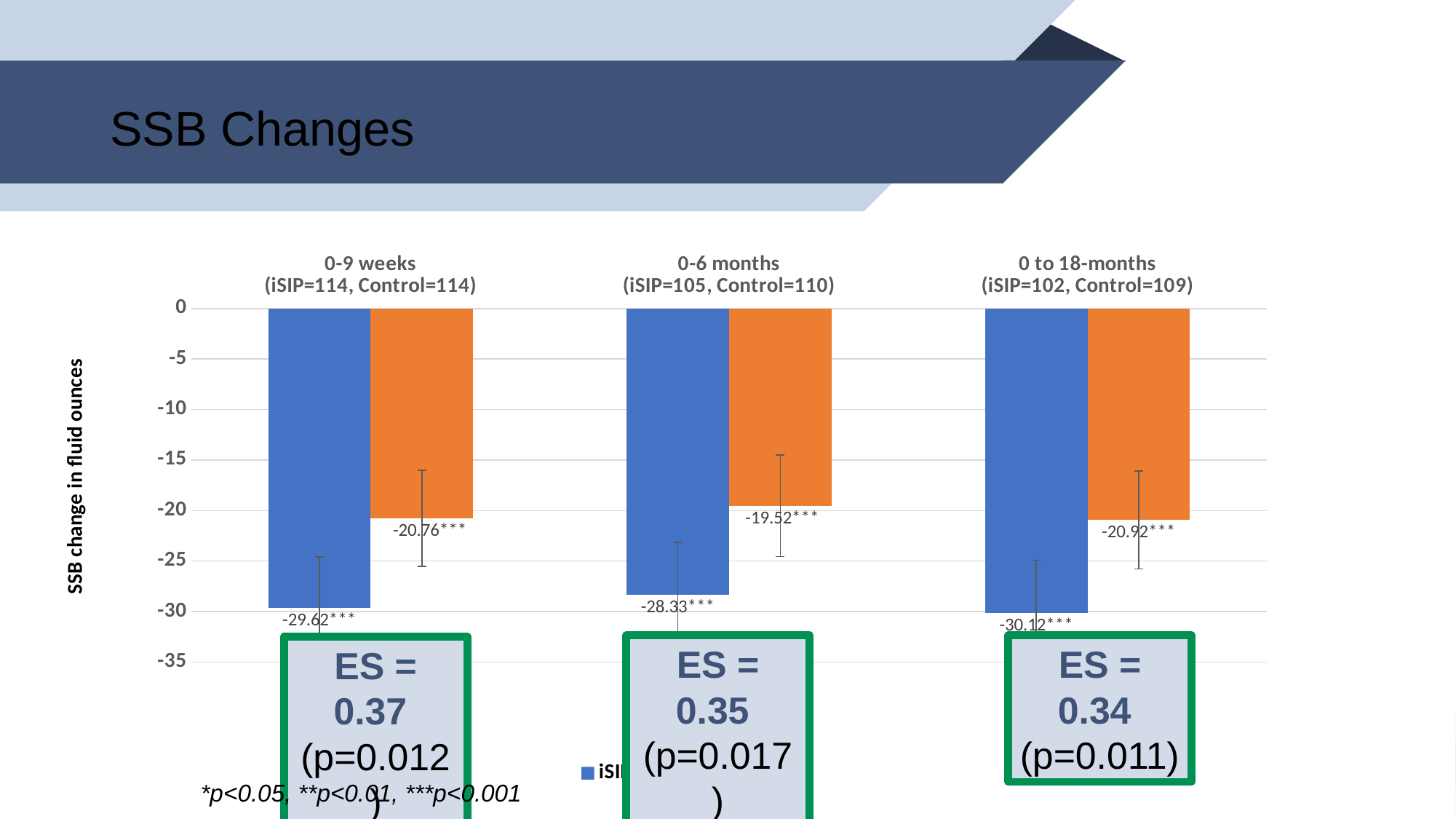
Which time period has the highest (least negative) orange bar value? 0-6 months What is the value of the blue bar for 0-9 weeks? -29.62 What is the difference between the blue bar and the orange bar for 0-9 weeks? 8.86 What is the value of the orange bar for 0-9 weeks? -20.76 What is the value of the blue bar for 0 to 18-months? -30.12 What is the difference between the blue bar and the orange bar for 0 to 18-months? 9.20 What is the title of the y axis? SSB change in fluid ounces Is the value of the blue bar for 0-6 months greater or less than -25? less What is the value of the orange bar for 0-6 months? -19.52 What type of chart is shown on the slide? bar chart How many time-period groups are shown on the x axis? 3 Which time period has the lowest (most negative) blue bar value? 0 to 18-months